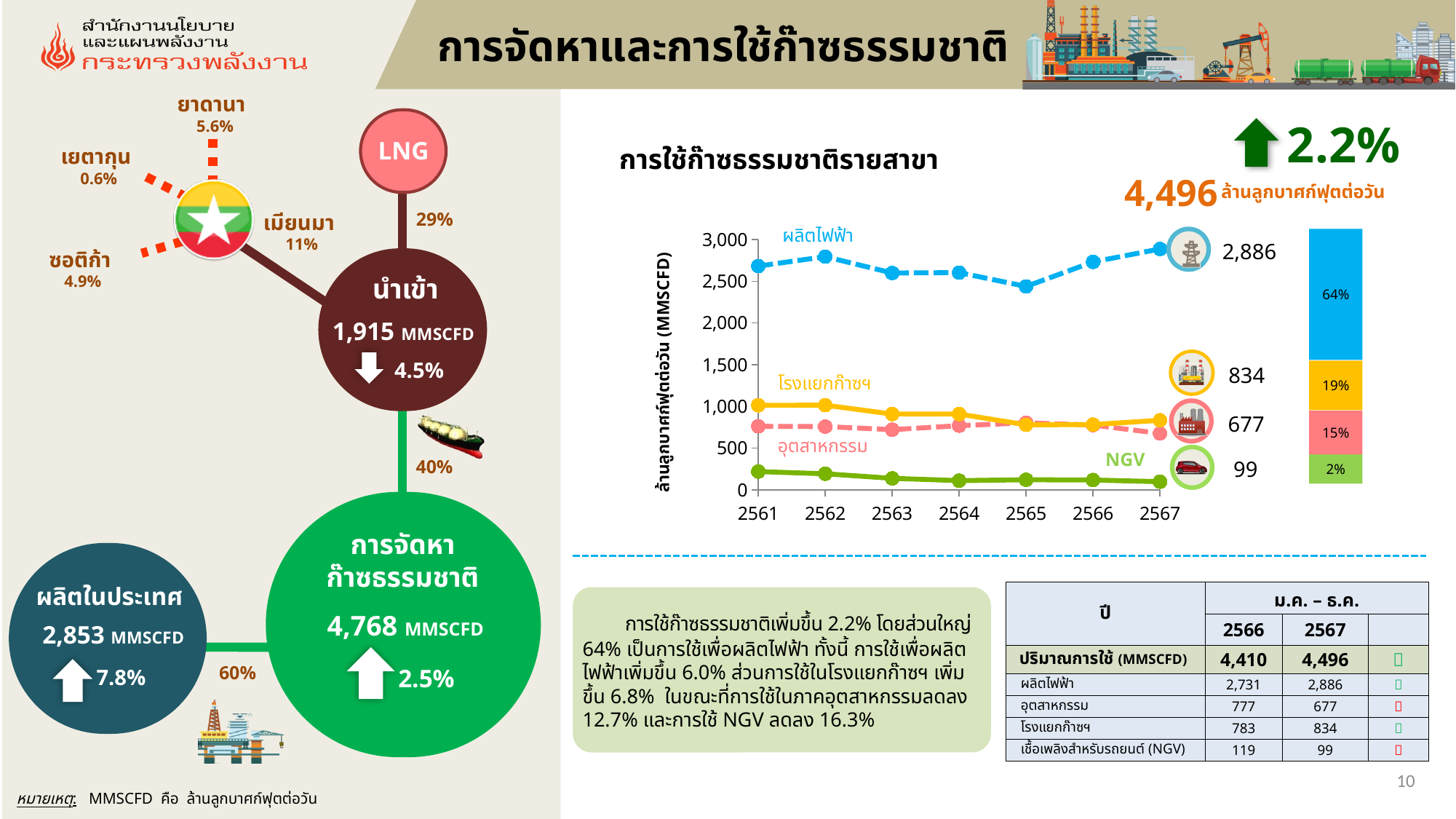
In the chart การใช้ก๊าซธรรมชาติรายสาขา, which series has the lowest value in 2567? NGV In the chart การใช้ก๊าซธรรมชาติรายสาขา, what is the value for NGV in 2567? 99 In the chart การใช้ก๊าซธรรมชาติรายสาขา, how many years are shown on the x axis? 7 In the chart การใช้ก๊าซธรรมชาติรายสาขา, what is the value for อุตสาหกรรม in 2567? 677 In the chart การใช้ก๊าซธรรมชาติรายสาขา, what is the value for โรงแยกก๊าซฯ in 2567? 834 In the chart การใช้ก๊าซธรรมชาติรายสาขา, which series has the highest value in 2567? ผลิตไฟฟ้า In the stacked bar next to the chart การใช้ก๊าซธรรมชาติรายสาขา, what share is shown for the blue (ผลิตไฟฟ้า) segment? 64% What type of chart is used for การใช้ก๊าซธรรมชาติรายสาขา? line chart In the chart การใช้ก๊าซธรรมชาติรายสาขา, is the value for ผลิตไฟฟ้า in 2565 greater or less than 2,500? less In the chart การใช้ก๊าซธรรมชาติรายสาขา, how many series are plotted? 4 In the chart การใช้ก๊าซธรรมชาติรายสาขา, what is the difference between โรงแยกก๊าซฯ and อุตสาหกรรม in 2567? 157 In the chart การใช้ก๊าซธรรมชาติรายสาขา, what is the value for ผลิตไฟฟ้า in 2567? 2,886